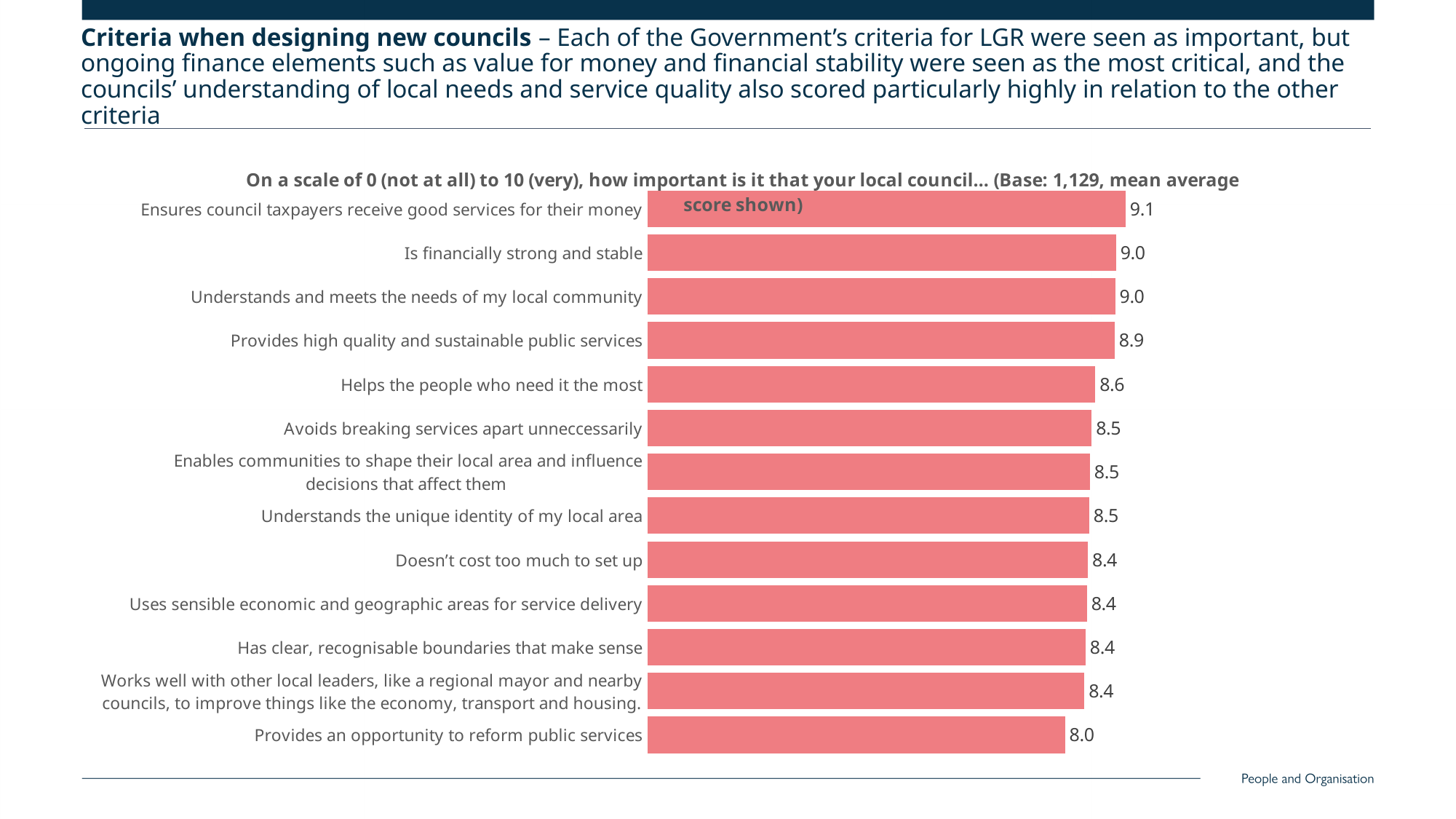
What is the mean score for 'Ensures council taxpayers receive good services for their money'? 9.1 What is the mean score for 'Provides an opportunity to reform public services'? 8.0 Which has a higher mean score: 'Helps the people who need it the most' or 'Avoids breaking services apart unneccessarily'? Helps the people who need it the most What is the mean score for 'Helps the people who need it the most'? 8.6 What type of chart is shown on the slide? Bar chart What is the mean score for 'Is financially strong and stable'? 9.0 Which criterion has the highest mean score? Ensures council taxpayers receive good services for their money What is the mean score for 'Doesn't cost too much to set up'? 8.4 How many criteria are shown in the chart? 13 What is the base (number of respondents) stated in the chart title? 1,129 Which criterion has the lowest mean score? Provides an opportunity to reform public services What is the difference between the mean scores for 'Ensures council taxpayers receive good services for their money' and 'Provides an opportunity to reform public services'? 1.1